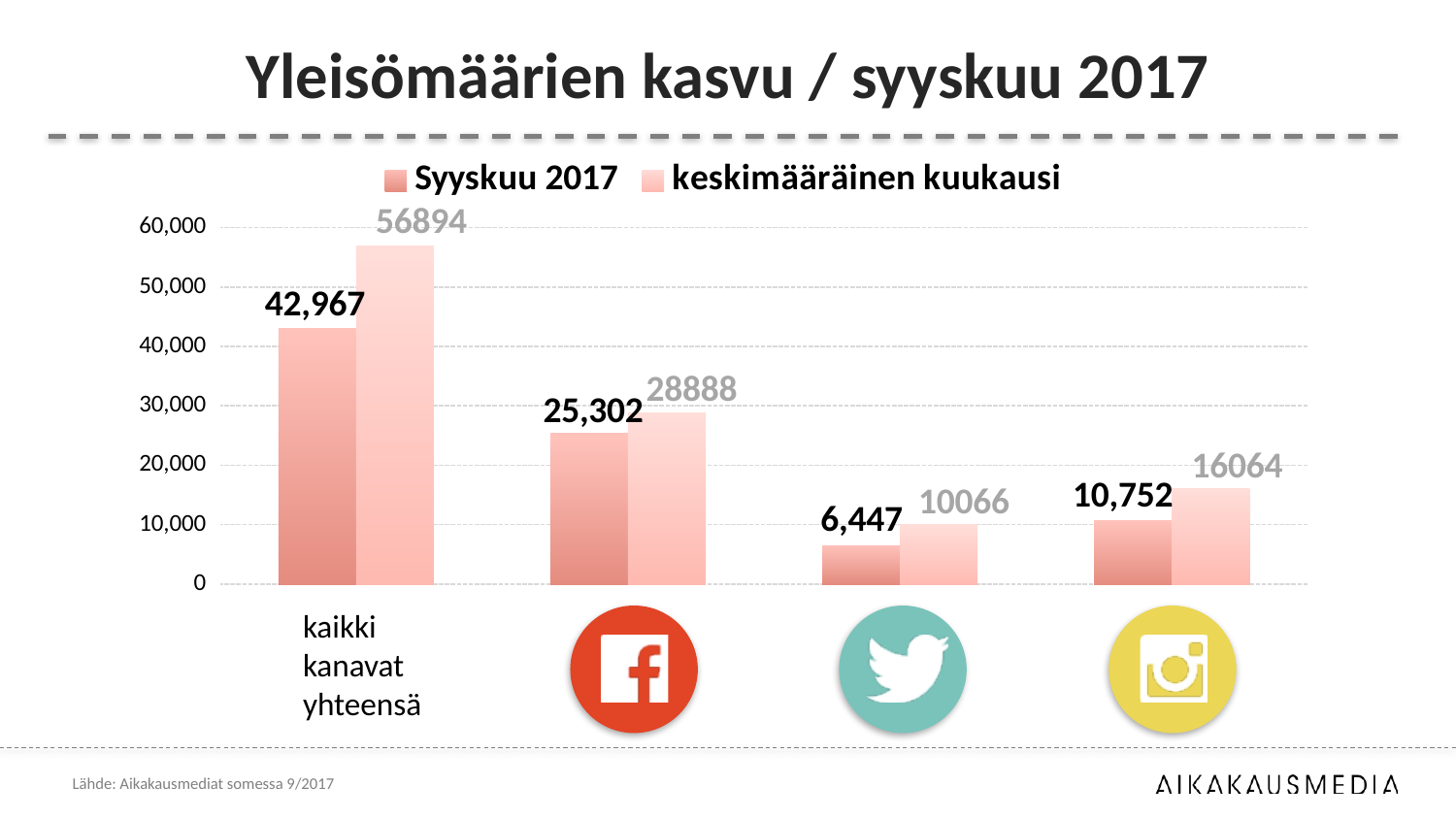
What is the keskimääräinen kuukausi value for the Twitter category? 10066 Which category has the highest keskimääräinen kuukausi value? kaikki kanavat yhteensä What is the difference between the keskimääräinen kuukausi and Syyskuu 2017 values for the Facebook category? 3586 What type of chart is shown on the slide? bar chart How many series does the legend list? 2 How many categories are shown on the x axis? 4 What is the Syyskuu 2017 value for the Instagram category? 10,752 What is the value for keskimääräinen kuukausi for 'kaikki kanavat yhteensä'? 56894 What is the Syyskuu 2017 value for the Facebook category? 25,302 What is the value for Syyskuu 2017 for 'kaikki kanavat yhteensä'? 42,967 Which category has the lowest Syyskuu 2017 value? Twitter Is the Syyskuu 2017 value for the Instagram category larger or smaller than the Syyskuu 2017 value for the Twitter category? larger